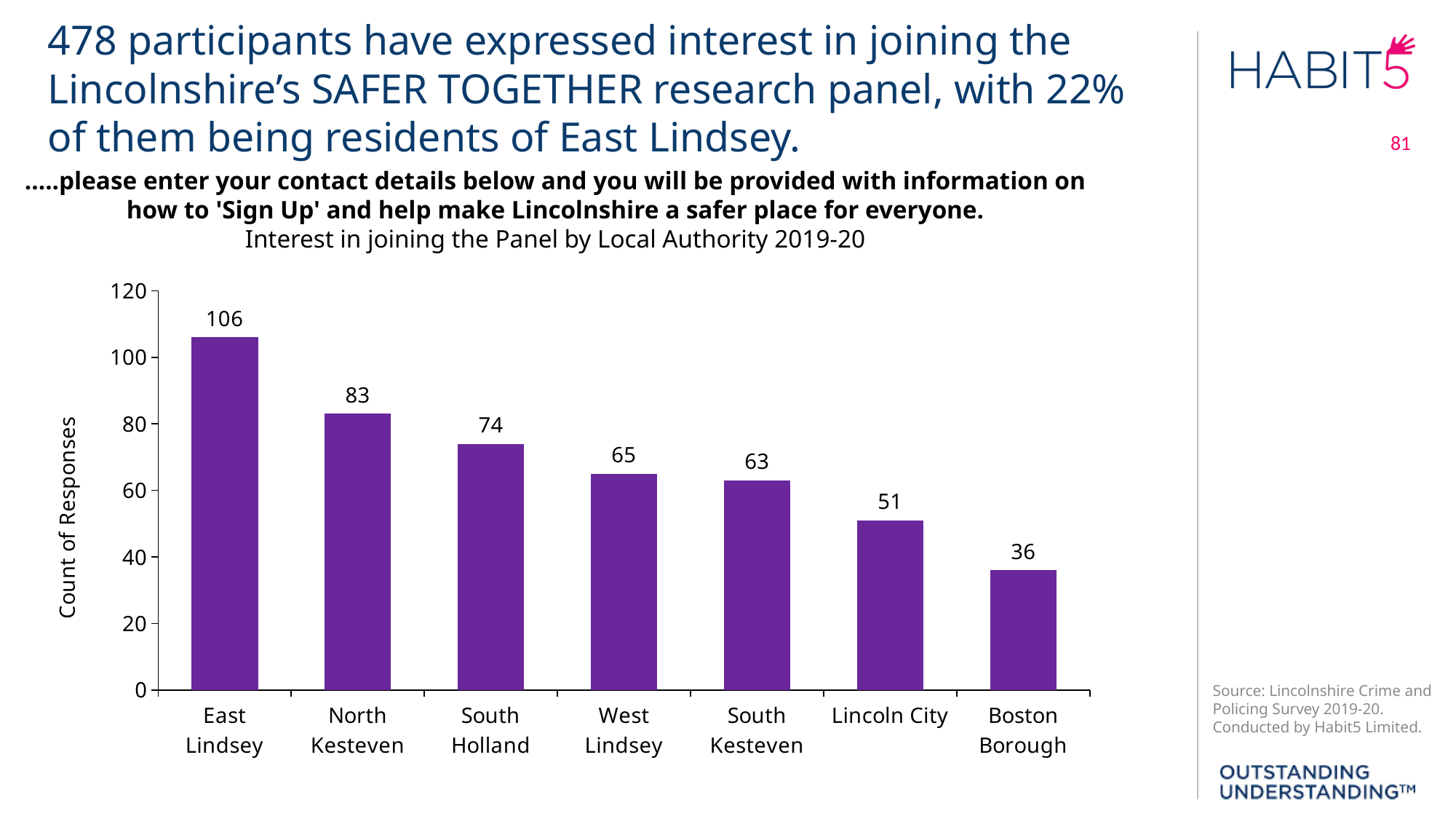
What is the count of responses for South Holland? 74 How many local authorities are shown on the chart? 7 Which local authority has the highest count of responses? East Lindsey What kind of chart is shown on the slide? Bar chart What is the count of responses for East Lindsey? 106 Is the value for Lincoln City greater or less than 60? less What is the title of the chart? Interest in joining the Panel by Local Authority 2019-20 What is the count of responses for Lincoln City? 51 What is the difference in count of responses between East Lindsey and North Kesteven? 23 Which has a higher count of responses, North Kesteven or South Kesteven? North Kesteven What is the difference in count of responses between West Lindsey and Boston Borough? 29 Which local authority has the lowest count of responses? Boston Borough